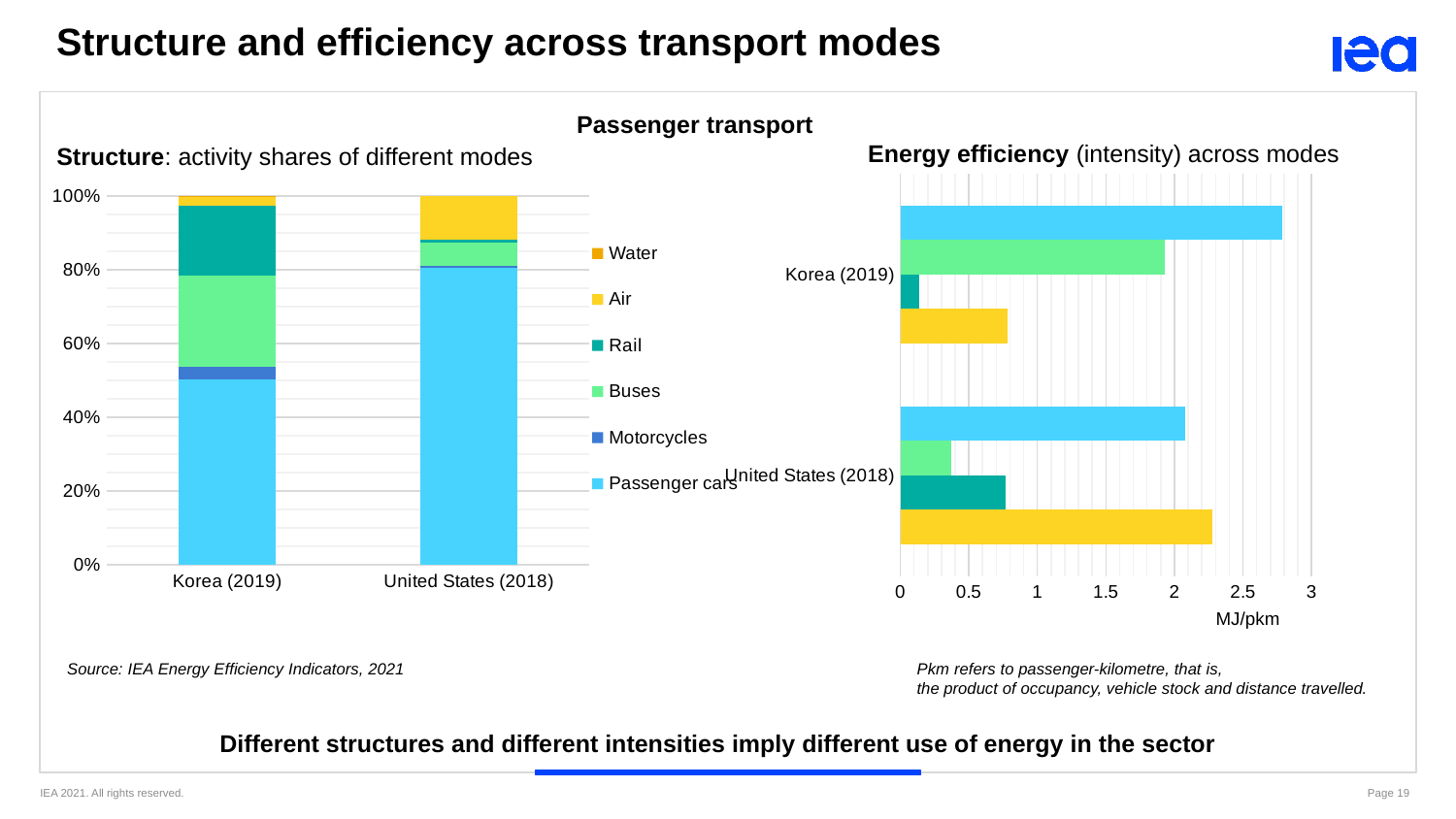
How many series does the legend of the left chart list? 6 What kind of chart is the left chart, 'Structure: activity shares of different modes'? stacked bar chart In the right chart, is the light green (buses) bar for United States (2018) greater or less than 0.5 MJ/pkm? less In the left chart, is the Passenger cars share for Korea (2019) greater or less than 40%? greater What unit is shown on the x axis of the right chart? MJ/pkm In the left chart, which mode has the largest activity share for United States (2018)? Passenger cars What kind of chart is the right chart, 'Energy efficiency (intensity) across modes'? bar chart In the right chart, is the light blue (passenger cars) bar for Korea (2019) greater or less than 2.5 MJ/pkm? greater In the right chart, which mode has the lowest intensity for Korea (2019)? Rail In the right chart, which country has the higher light blue (passenger cars) intensity, Korea (2019) or United States (2018)? Korea (2019) How many countries are shown on the x axis of the left chart? 2